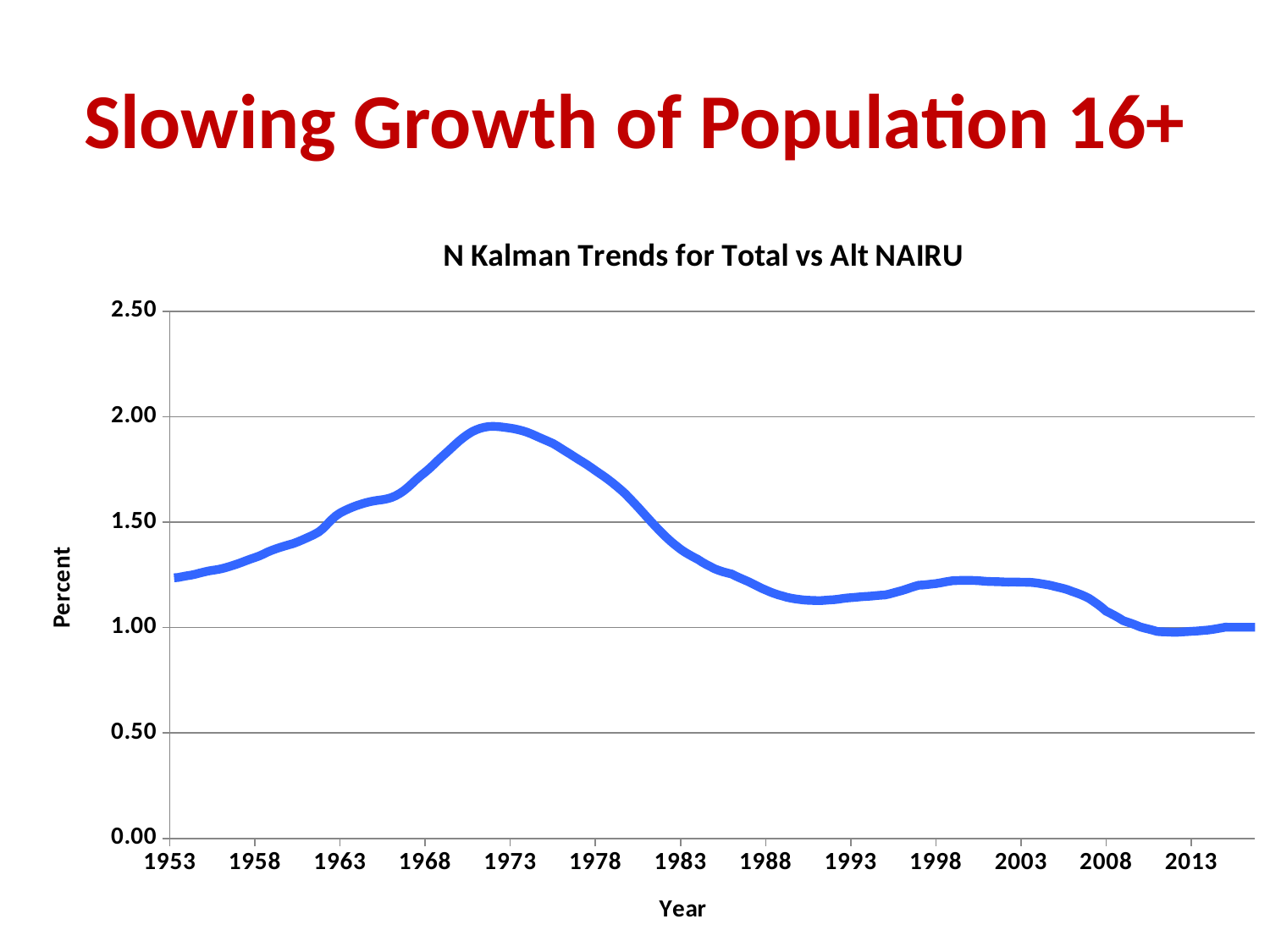
Is the value for 1963 greater or less than 2.00? less What kind of chart is shown on the slide? line chart Does the line rise or fall between 1953 and 1973? rise What is the title of the chart? N Kalman Trends for Total vs Alt NAIRU Is the value for 1973 greater or less than 1.50? greater Is the value for 1953 greater or less than 1.00? greater Which of 1973 or 2013 has the higher value? 1973 Does the line rise or fall between 1973 and 1993? fall What is the label of the vertical axis? Percent